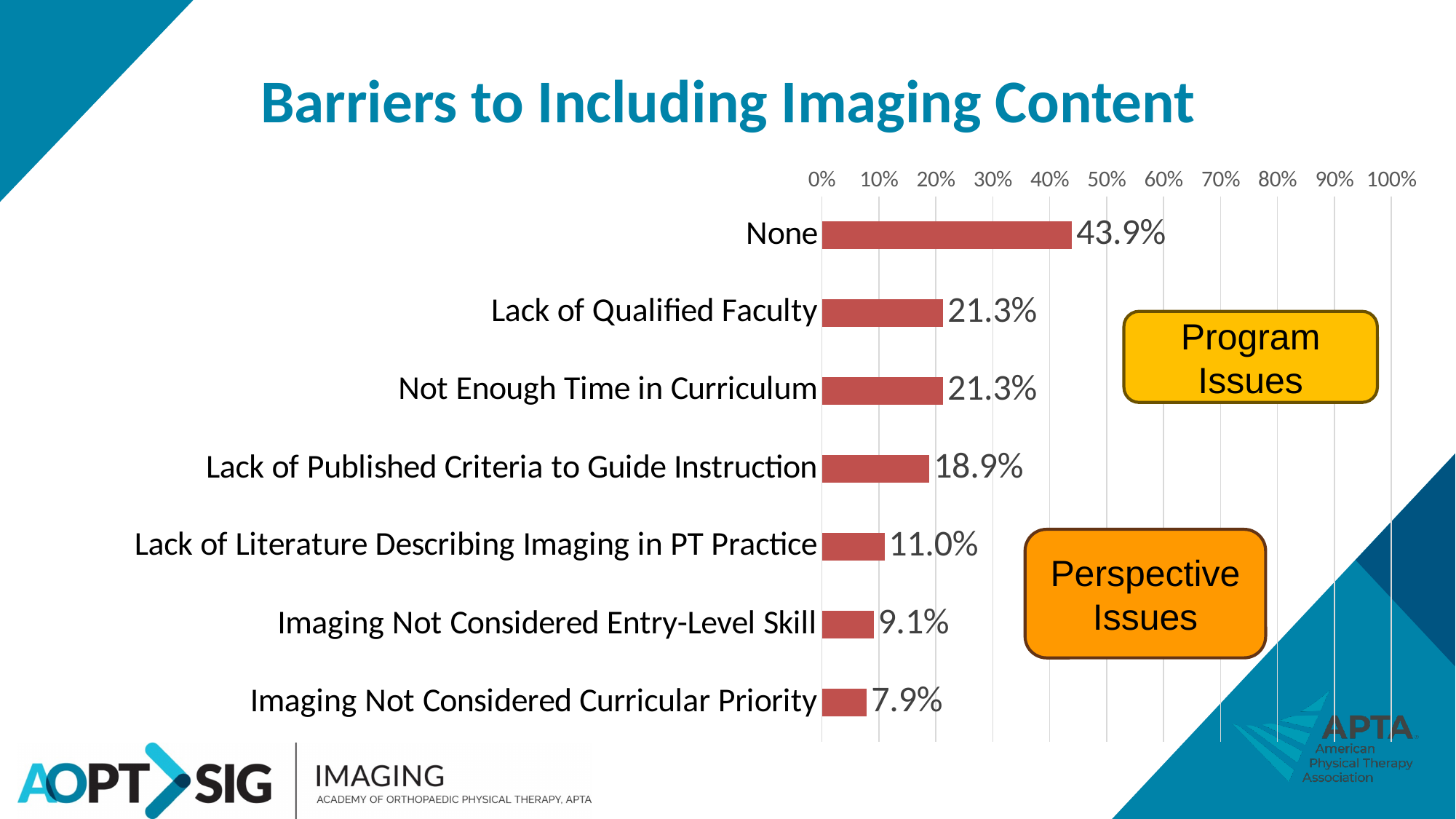
Which category has the lowest value? Imaging Not Considered Curricular Priority What is the difference between the values for Lack of Literature Describing Imaging in PT Practice and Imaging Not Considered Curricular Priority? 3.1% What kind of chart is shown on the slide? Bar chart How many categories are shown in the chart? 7 What is the value for Imaging Not Considered Entry-Level Skill? 9.1% What is the value for Lack of Published Criteria to Guide Instruction? 18.9% Is the value for None greater or less than 40%? greater What is the difference between the values for None and Lack of Qualified Faculty? 22.6% Which is larger, the value for Lack of Published Criteria to Guide Instruction or the value for Lack of Literature Describing Imaging in PT Practice? Lack of Published Criteria to Guide Instruction Which category has the highest value? None What is the title of the chart? Barriers to Including Imaging Content What is the value for None? 43.9%